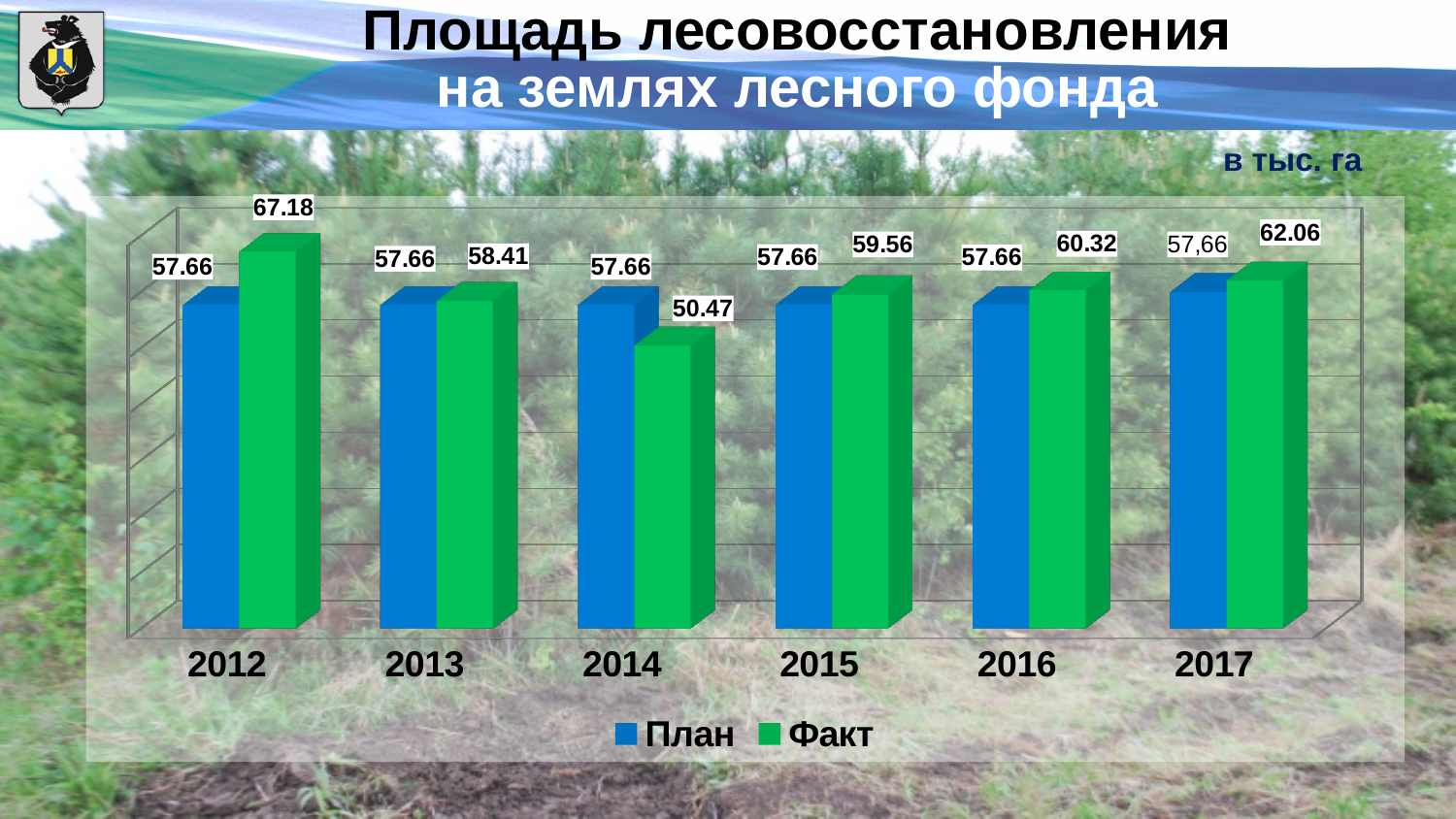
What is the Факт value for 2012? 67.18 What is the Факт value for 2017? 62.06 In which year is the Факт value lowest? 2014 What is the difference between the Факт values for 2016 and 2015? 0.76 What is the План value for 2015? 57.66 In which year is the Факт value highest? 2012 What kind of chart is shown on the slide? Bar chart How many series does the legend list? 2 What is the difference between the Факт and План values in 2012? 9.52 What is the Факт value for 2014? 50.47 How many years are shown on the x axis? 6 Which is larger in 2014, the План value or the Факт value? План